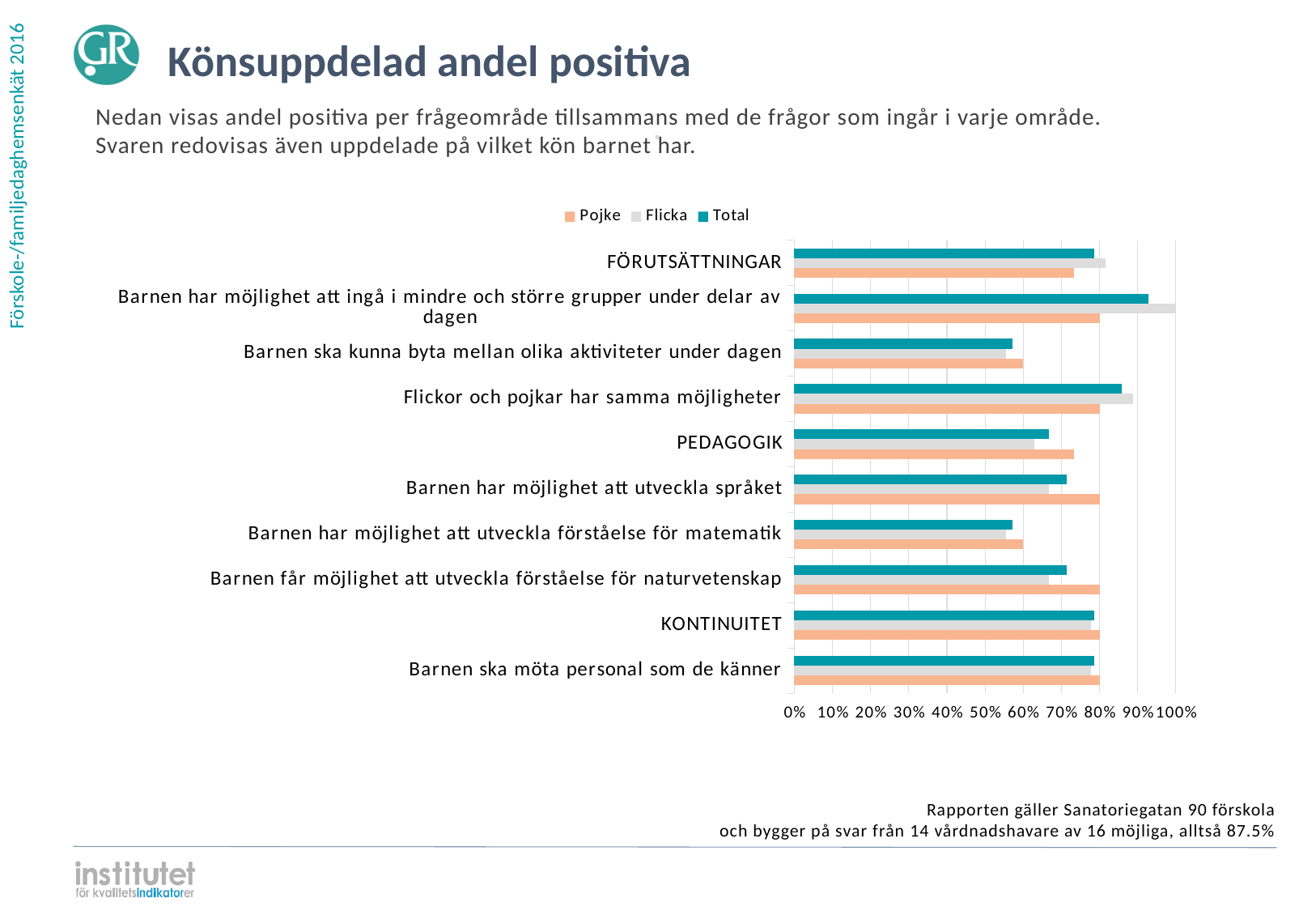
What are the three legend entries of the chart? Pojke, Flicka, Total Is the Total value for 'Barnen ska kunna byta mellan olika aktiviteter under dagen' greater or less than 70%? less How many series does the legend list? 3 Is the Total value for 'Barnen har möjlighet att utveckla förståelse för matematik' greater or less than 70%? less For PEDAGOGIK, which is larger: the Pojke value or the Flicka value? Pojke What is the title of the slide containing the chart? Könsuppdelad andel positiva Is the Flicka value for 'Barnen har möjlighet att ingå i mindre och större grupper under delar av dagen' greater or less than 90%? greater What kind of chart is shown on the slide? Bar chart Which category has the highest Total value? Barnen har möjlighet att ingå i mindre och större grupper under delar av dagen For FÖRUTSÄTTNINGAR, which is larger: the Flicka value or the Pojke value? Flicka How many categories are plotted on the y axis of the chart? 10